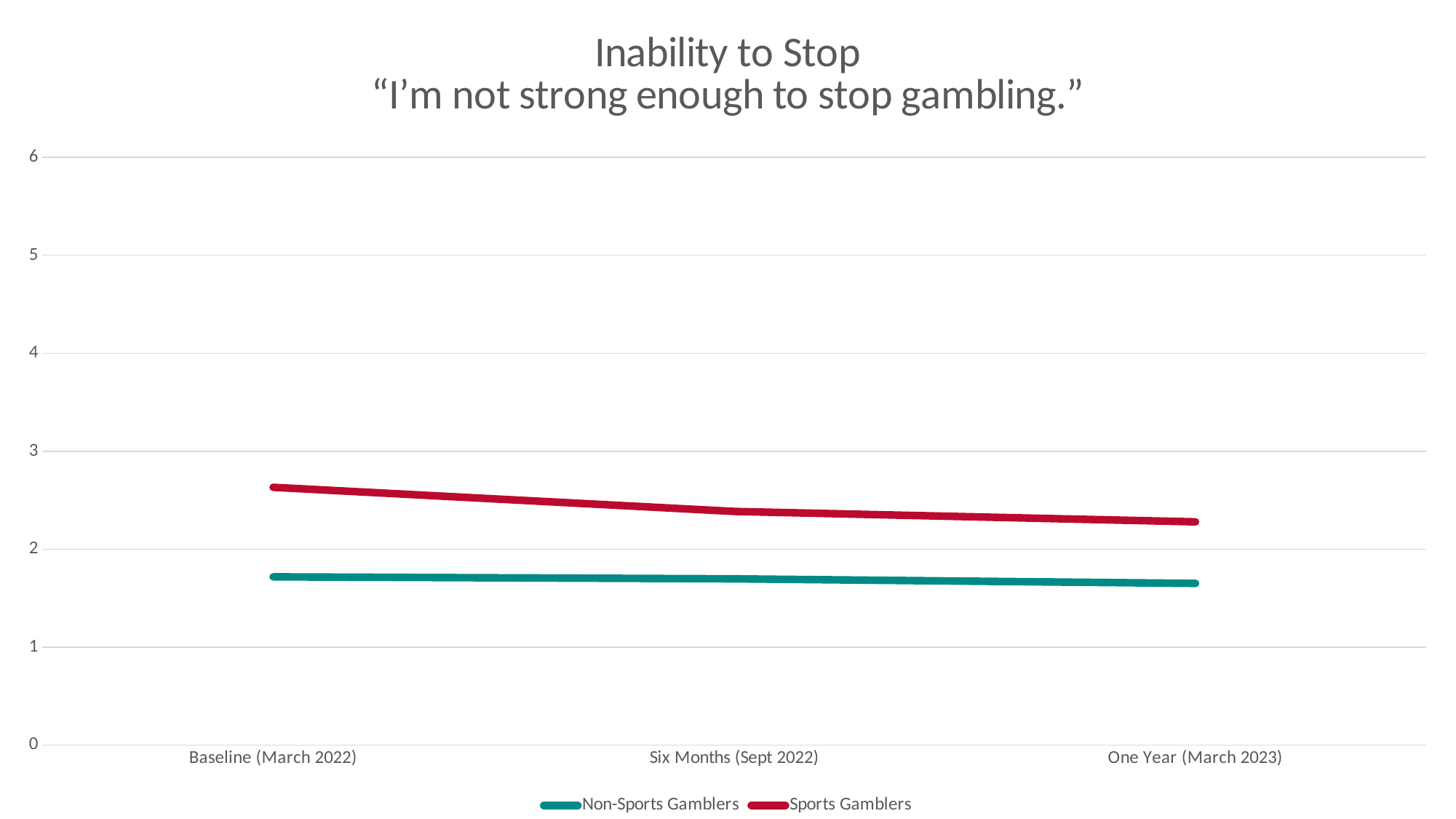
Is the value for Non-Sports Gamblers at Baseline (March 2022) greater or less than 2? less What kind of chart is shown on the slide? line chart Which series is drawn in red? Sports Gamblers Is the value for Sports Gamblers at Baseline (March 2022) greater or less than 3? less How many time points are plotted along the x axis? 3 Which series has the lower value at One Year (March 2023)? Non-Sports Gamblers Which series has the higher value at Baseline (March 2022)? Sports Gamblers Is the value for Non-Sports Gamblers at Six Months (Sept 2022) greater or less than 1? greater Do the values for Sports Gamblers rise or fall from Baseline (March 2022) to One Year (March 2023)? fall What is the title of the chart? Inability to Stop “I’m not strong enough to stop gambling.” How many series does the legend list? 2